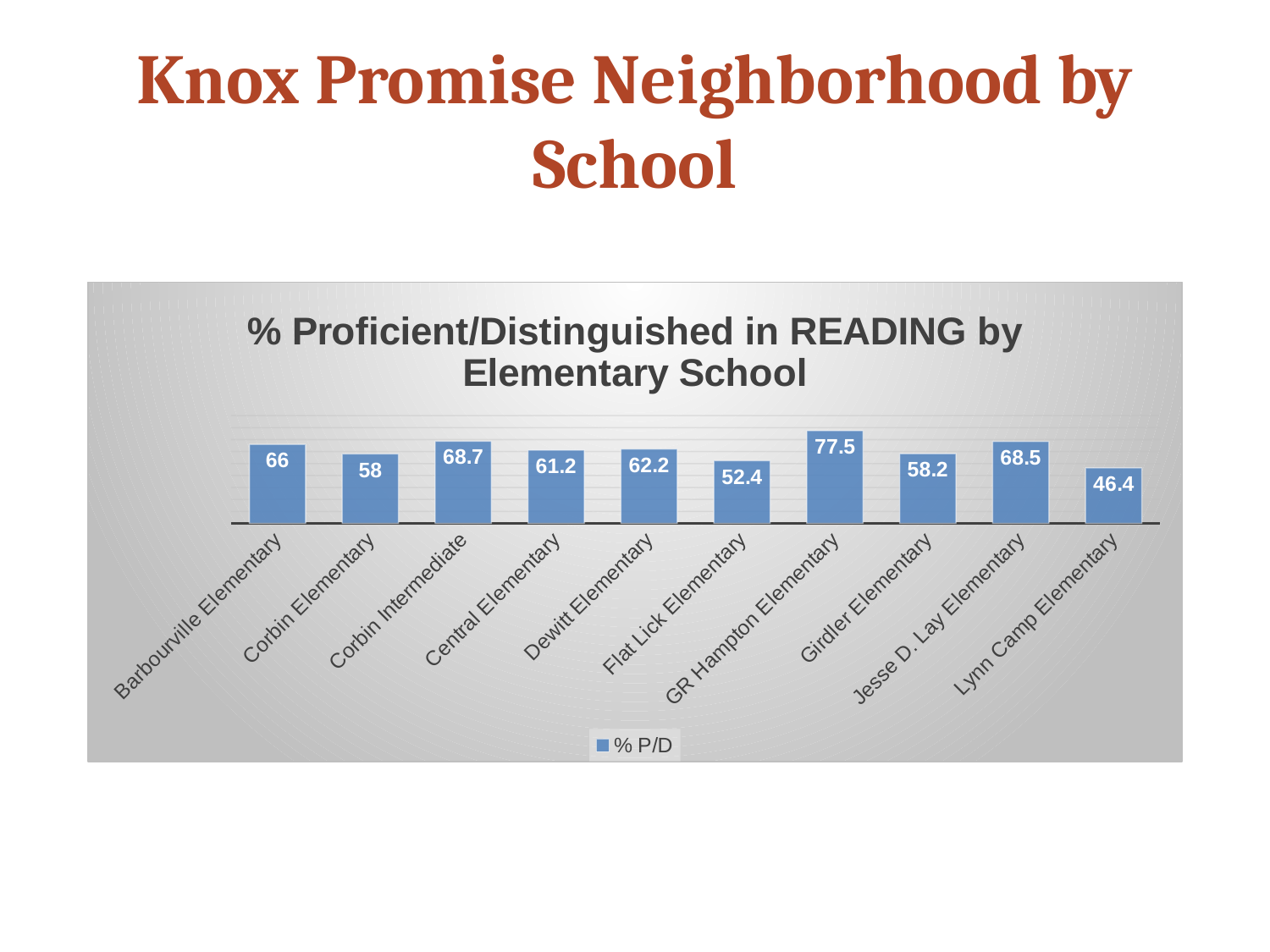
What kind of chart is shown on the slide? Bar chart Which school has the lowest % P/D value? Lynn Camp Elementary What is the % P/D value for Lynn Camp Elementary? 46.4 What is the % P/D value for Corbin Intermediate? 68.7 How many series does the legend list? 1 How many schools are shown in the chart? 10 Which has a larger % P/D value, Jesse D. Lay Elementary or Girdler Elementary? Jesse D. Lay Elementary What is the difference between the % P/D values for Barbourville Elementary and Corbin Elementary? 8 What is the % P/D value for GR Hampton Elementary? 77.5 What is the difference between the % P/D values for GR Hampton Elementary and Lynn Camp Elementary? 31.1 Which school has the highest % P/D value? GR Hampton Elementary Which has a larger % P/D value, Dewitt Elementary or Flat Lick Elementary? Dewitt Elementary